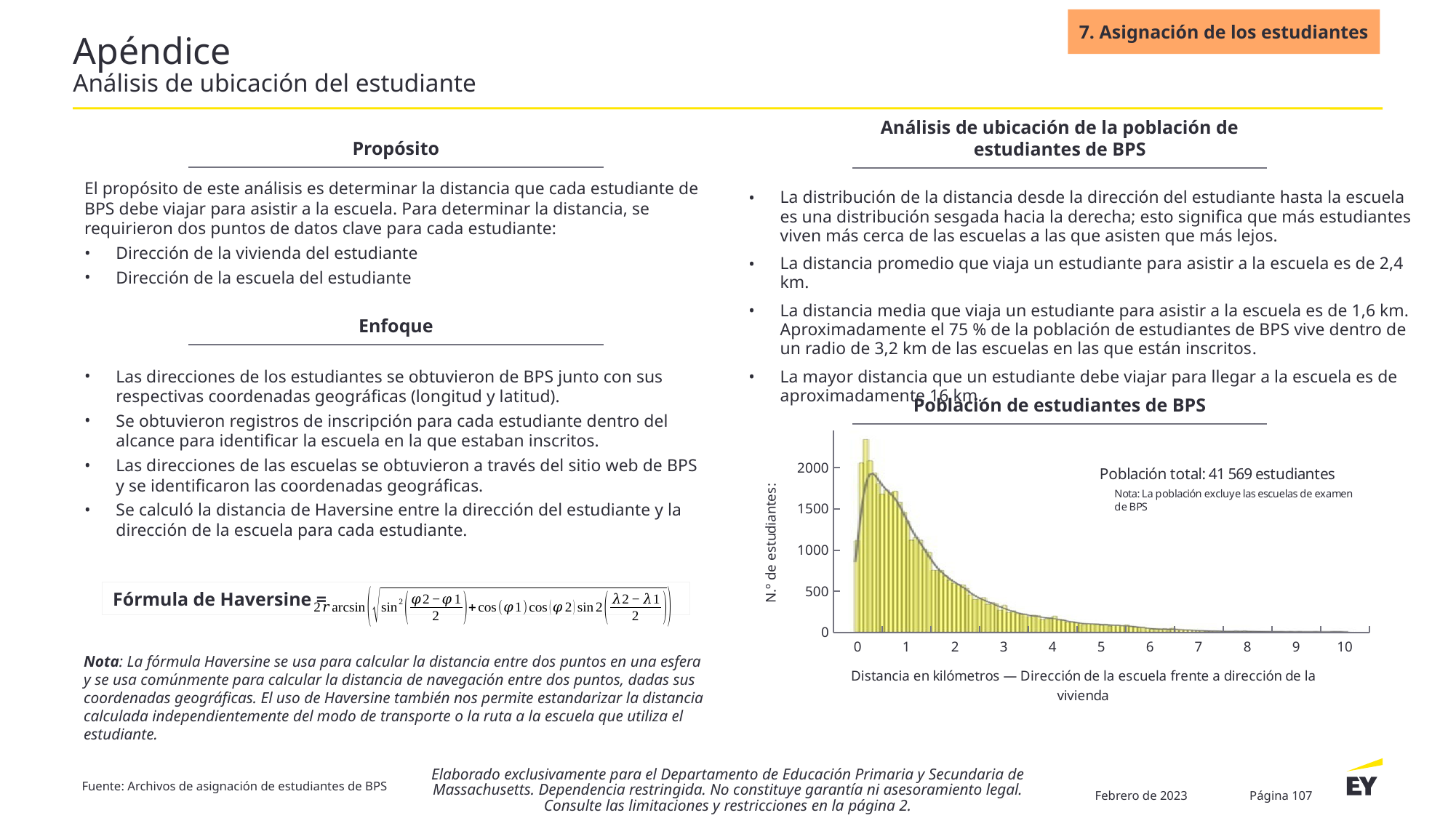
What is the total population of students stated on the chart? 41 569 estudiantes What kind of chart is shown under the title "Población de estudiantes de BPS"? bar chart (histogram) Is the tallest bar in the histogram greater or less than 2000 students? greater What is the label of the y axis of the chart? N.° de estudiantes Is the number of students at a distance of 8 km greater or less than 500? less Do the bar heights rise or fall as the distance increases from 1 km to 10 km? fall What is the title of the chart on the right side of the slide? Población de estudiantes de BPS What is the highest value shown on the x axis of the chart? 10 What is the highest tick value shown on the y axis of the chart? 2000 Which distance has more students: around 1 km or around 6 km? around 1 km Is the number of students at a distance of 3 km greater or less than 1000? less